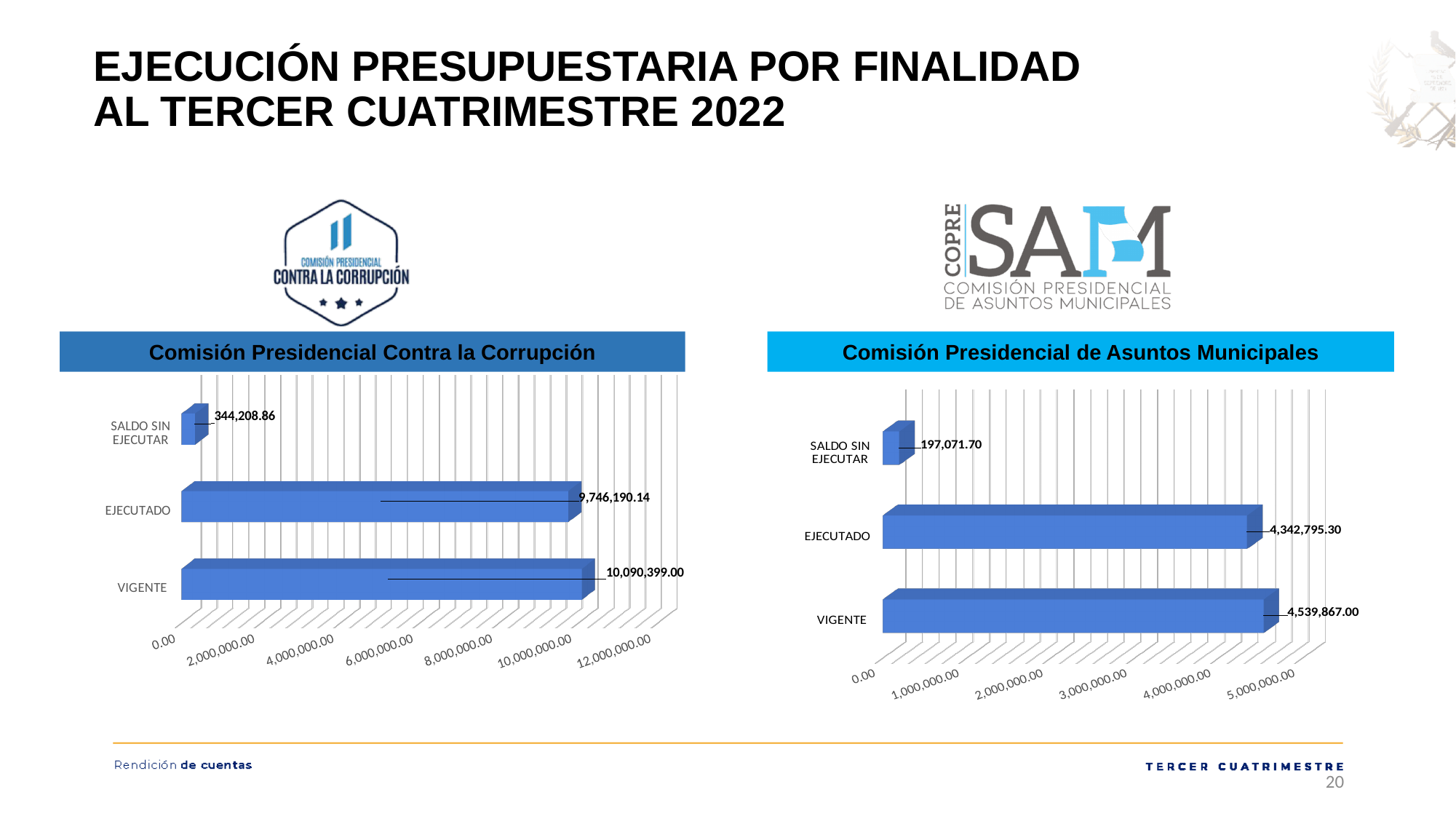
In the 'Comisión Presidencial de Asuntos Municipales' chart, what is the difference between VIGENTE and EJECUTADO? 197,071.70 In the 'Comisión Presidencial de Asuntos Municipales' chart, which category has the lowest value? SALDO SIN EJECUTAR In the 'Comisión Presidencial de Asuntos Municipales' chart, what is the value for VIGENTE? 4,539,867.00 In the 'Comisión Presidencial Contra la Corrupción' chart, which category has the highest value? VIGENTE In the 'Comisión Presidencial Contra la Corrupción' chart, what is the value for EJECUTADO? 9,746,190.14 In the 'Comisión Presidencial Contra la Corrupción' chart, what is the value for SALDO SIN EJECUTAR? 344,208.86 Which is larger: EJECUTADO in the 'Comisión Presidencial Contra la Corrupción' chart or VIGENTE in the 'Comisión Presidencial de Asuntos Municipales' chart? EJECUTADO in the Comisión Presidencial Contra la Corrupción chart In the 'Comisión Presidencial Contra la Corrupción' chart, what is the difference between VIGENTE and EJECUTADO? 344,208.86 How many categories are shown in the 'Comisión Presidencial Contra la Corrupción' chart? 3 What kind of chart is the 'Comisión Presidencial de Asuntos Municipales' chart? Bar chart In the 'Comisión Presidencial de Asuntos Municipales' chart, what is the value for SALDO SIN EJECUTAR? 197,071.70 In the 'Comisión Presidencial de Asuntos Municipales' chart, is the value for EJECUTADO greater or less than 4,000,000.00? greater